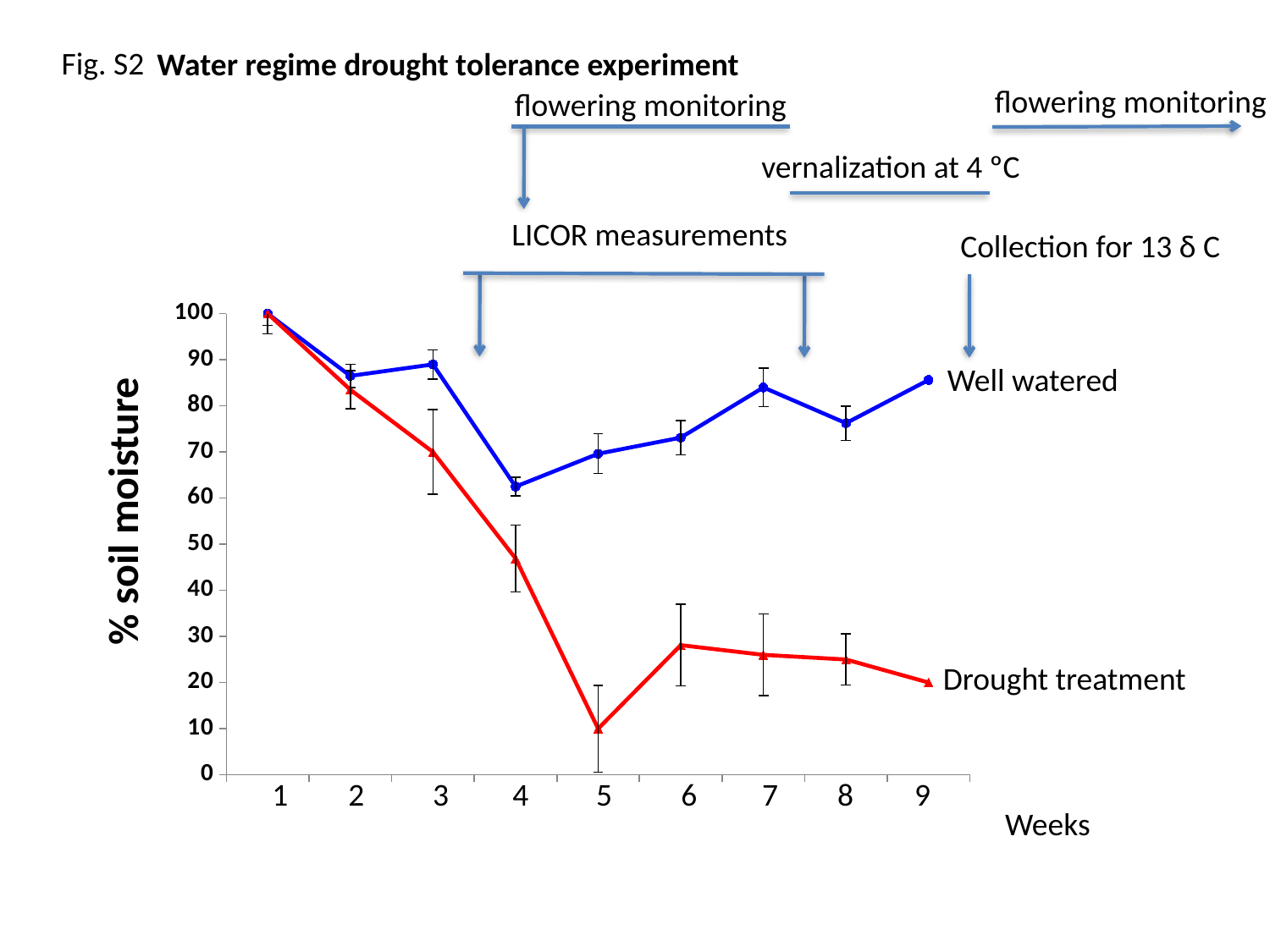
What kind of chart is shown on the slide? line chart Is the Well watered % soil moisture at week 7 greater or less than 80? greater How many series are plotted on the chart? 2 Is the Drought treatment % soil moisture at week 6 greater or less than 40? less Does the Drought treatment % soil moisture rise or fall from week 1 to week 5? fall At which week is the Drought treatment % soil moisture lowest? 5 What is the % soil moisture for the Well watered series at week 1? 100 At which week is the Well watered % soil moisture highest? 1 How many weeks are shown on the x axis of the chart? 9 What is the label of the y axis? % soil moisture At week 8, which series has the higher % soil moisture, Well watered or Drought treatment? Well watered At which week is the Well watered % soil moisture lowest? 4